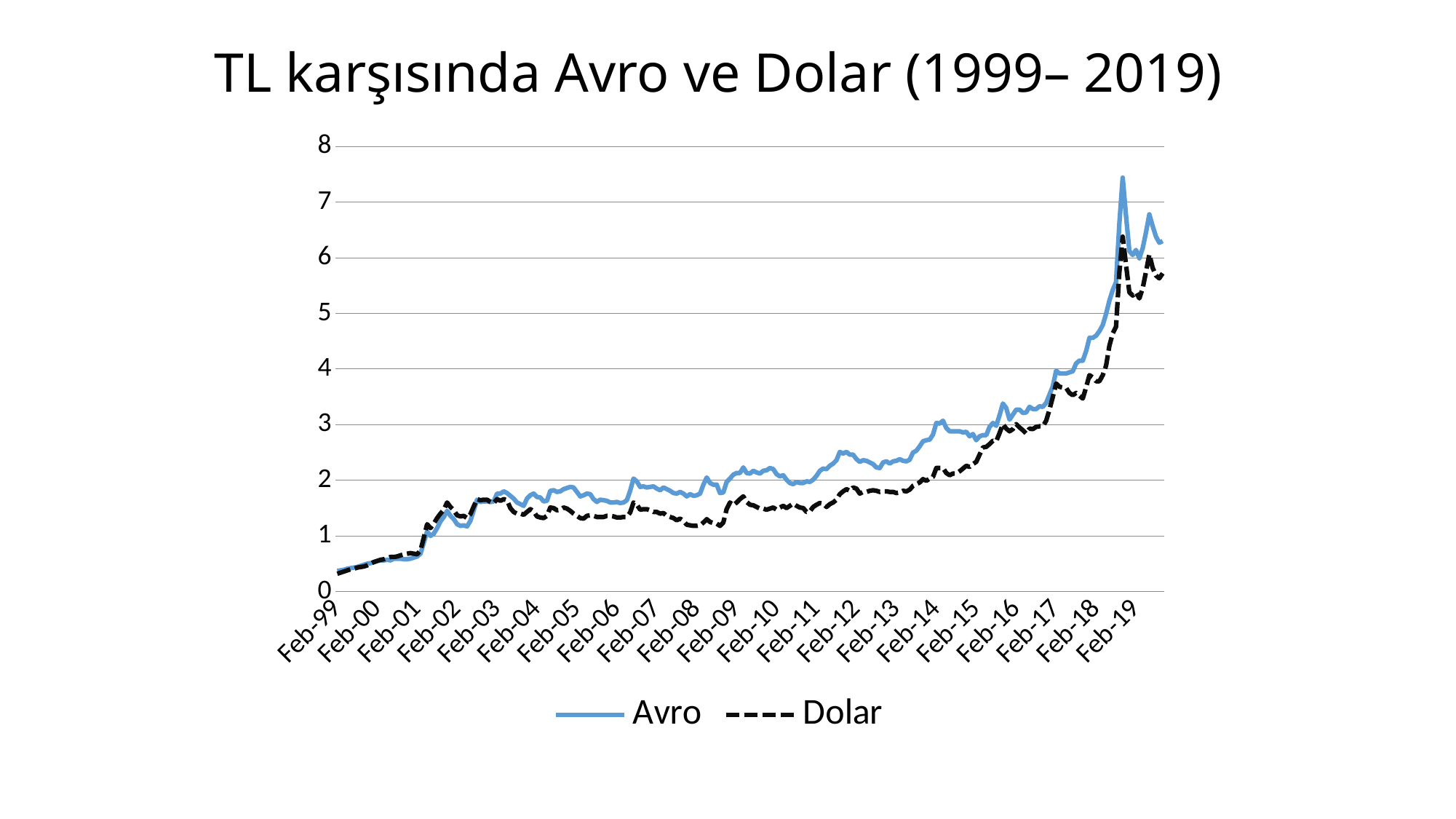
Which series reaches the highest value on the chart? Avro What kind of chart is shown on the slide? line chart Do the values for Avro generally rise or fall from Feb-99 to Feb-19? rise How many year labels are shown on the x axis? 21 Is the peak value for Avro greater or less than 7? greater Is the value for Dolar at Feb-17 greater or less than 5? less Is the value for Dolar at Feb-05 greater or less than 2? less What is the title of the chart? TL karşısında Avro ve Dolar (1999– 2019) Which series is drawn with a dashed line? Dolar How many series does the legend list? 2 At Feb-15, which series has the larger value, Avro or Dolar? Avro